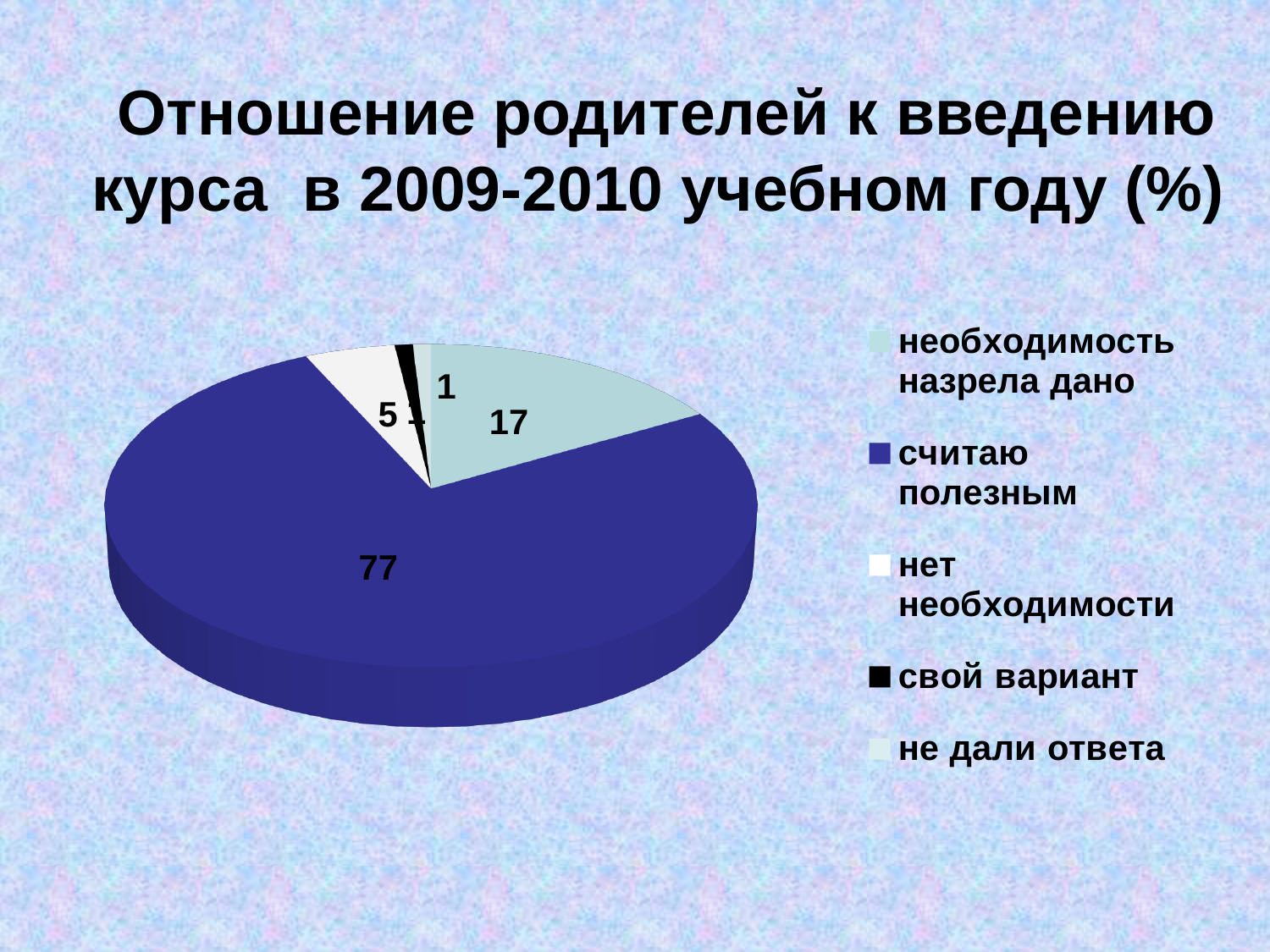
What is the difference between the "считаю полезным" and "необходимость назрела дано" values? 60 What percentage of parents answered "считаю полезным"? 77 What value is shown for the "свой вариант" slice? 1 What value is shown for the "нет необходимости" slice? 5 What is the title of the slide? Отношение родителей к введению курса в 2009-2010 учебном году (%) What kind of chart is shown on the slide? pie chart Which category has the largest slice of the pie? считаю полезным What is the difference between the "необходимость назрела дано" and "нет необходимости" values? 12 What colour is the slice for "считаю полезным"? dark blue What value is shown for the "необходимость назрела дано" slice? 17 How many categories does the pie chart have? 5 Which is larger: the value for "нет необходимости" or the value for "необходимость назрела дано"? необходимость назрела дано